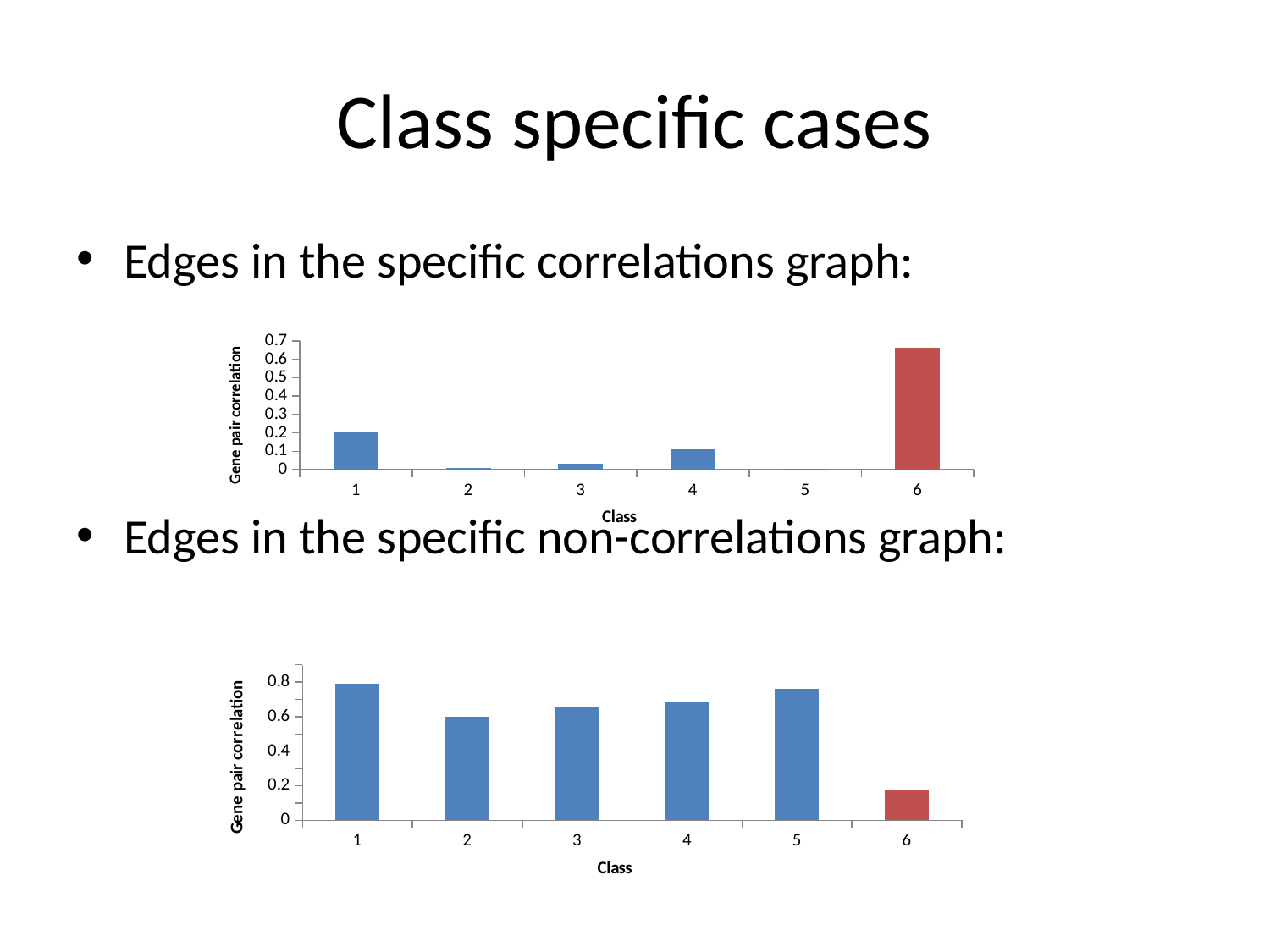
In the bottom chart (specific non-correlations graph), is the value for class 6 greater or less than 0.2? less In the top chart (specific correlations graph), how many classes are shown on the x axis? 6 In the bottom chart (specific non-correlations graph), which has a larger value, class 1 or class 2? class 1 In the bottom chart (specific non-correlations graph), which class has the lowest gene pair correlation? 6 In the top chart (specific correlations graph), which class has the highest gene pair correlation? 6 What kind of chart is the bottom chart (specific non-correlations graph)? bar chart In the top chart (specific correlations graph), is the value for class 1 greater or less than 0.1? greater In the top chart (specific correlations graph), is the value for class 6 greater or less than 0.6? greater In the top chart (specific correlations graph), which has a larger value, class 1 or class 4? class 1 In the bottom chart (specific non-correlations graph), what is the label of the y axis? Gene pair correlation